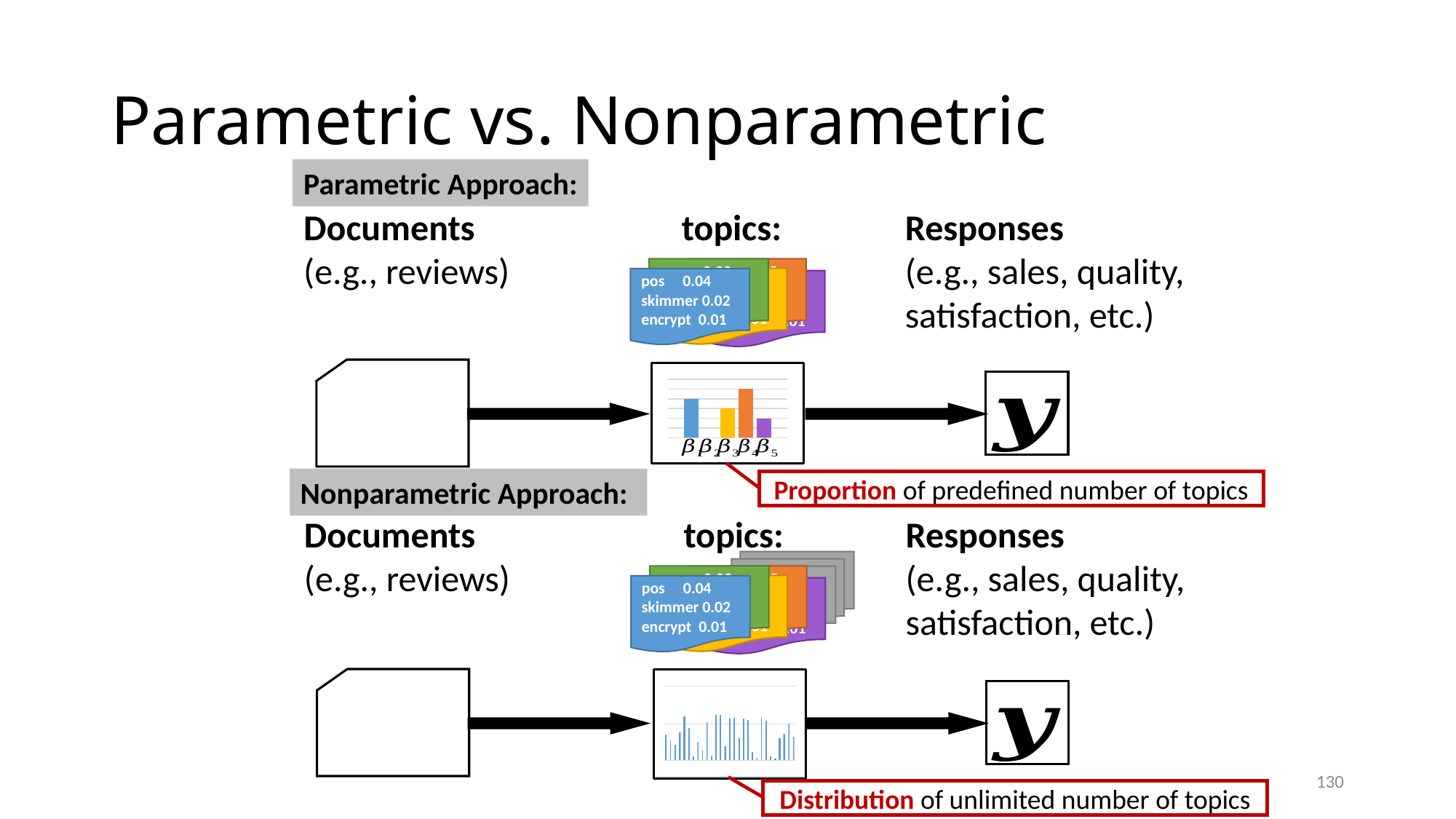
In the Parametric Approach chart, which bar is taller, β2 or β5? β5 In the Parametric Approach chart, which bar is taller, β3 or β4? β4 What kind of chart is shown in the Parametric Approach diagram (the chart labelled with β1 to β5)? bar chart In the Parametric Approach chart, which bar is taller, β1 or β2? β1 In the Parametric Approach chart, which category has the shortest bar? β5 According to the red annotation, what does the Parametric Approach chart represent? Proportion of predefined number of topics What kind of chart is shown in the Nonparametric Approach diagram (the chart with many thin blue bars)? bar chart How many bars are plotted in the Parametric Approach chart (the chart labelled with β1 to β5)? 4 What colour is the tallest bar (β4) in the Parametric Approach chart? orange In the Parametric Approach chart, which category has the tallest bar? β4